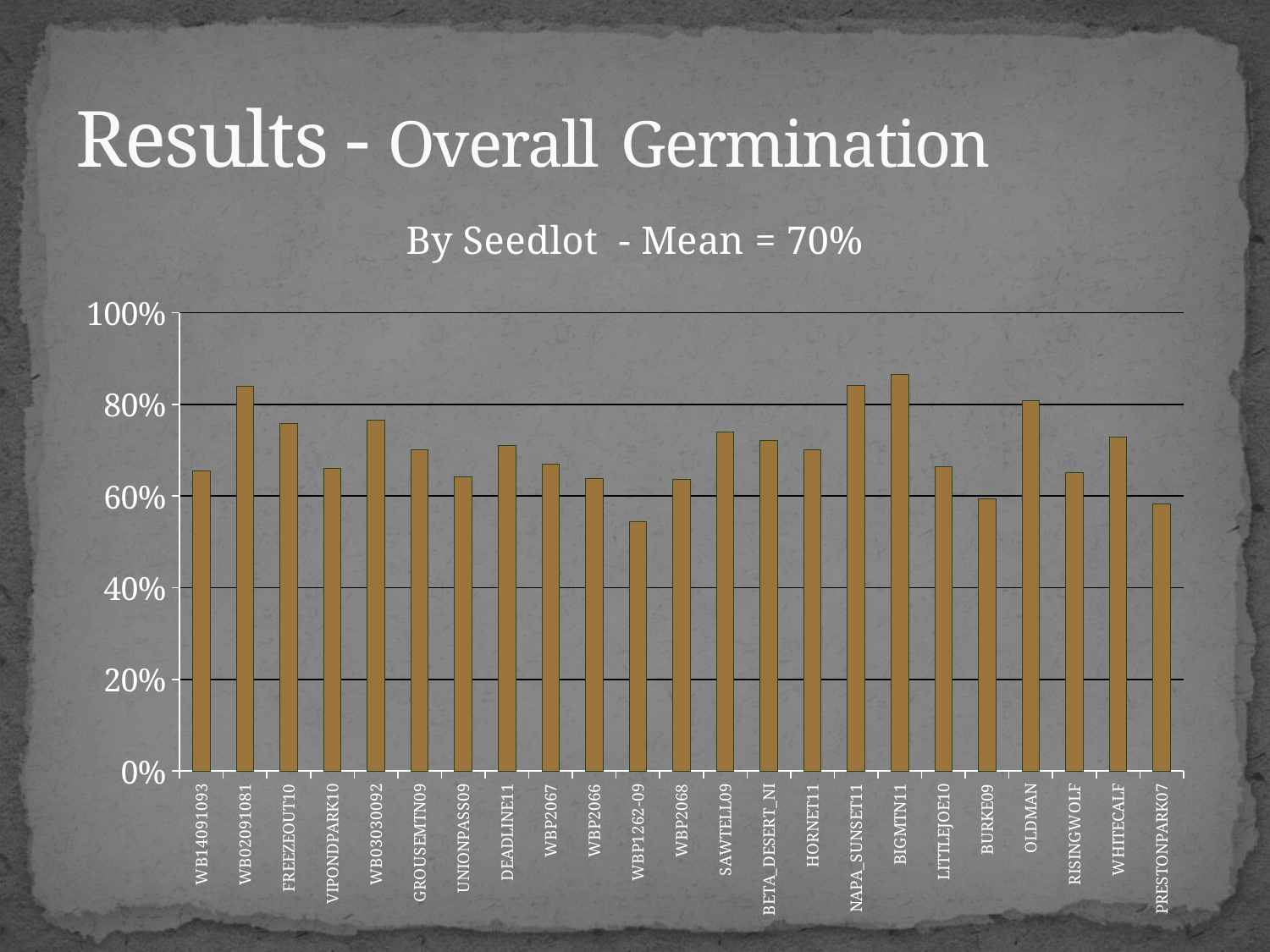
Which has the higher germination rate, WB02091081 or WB14091093? WB02091081 What kind of chart is shown on the slide? bar chart Is the value for WB02091081 greater or less than 80%? greater Is the value for FREEZEOUT10 greater or less than 80%? less Which seedlot has the lowest germination rate? WBP1262-09 Which has the higher germination rate, SAWTELL09 or WBP1262-09? SAWTELL09 How many seedlots are plotted on the chart? 23 What mean germination value is stated in the chart subtitle? 70% What is the highest value shown on the vertical axis? 100% Is the value for BIGMTN11 greater or less than 80%? greater Which seedlot has the highest germination rate? BIGMTN11